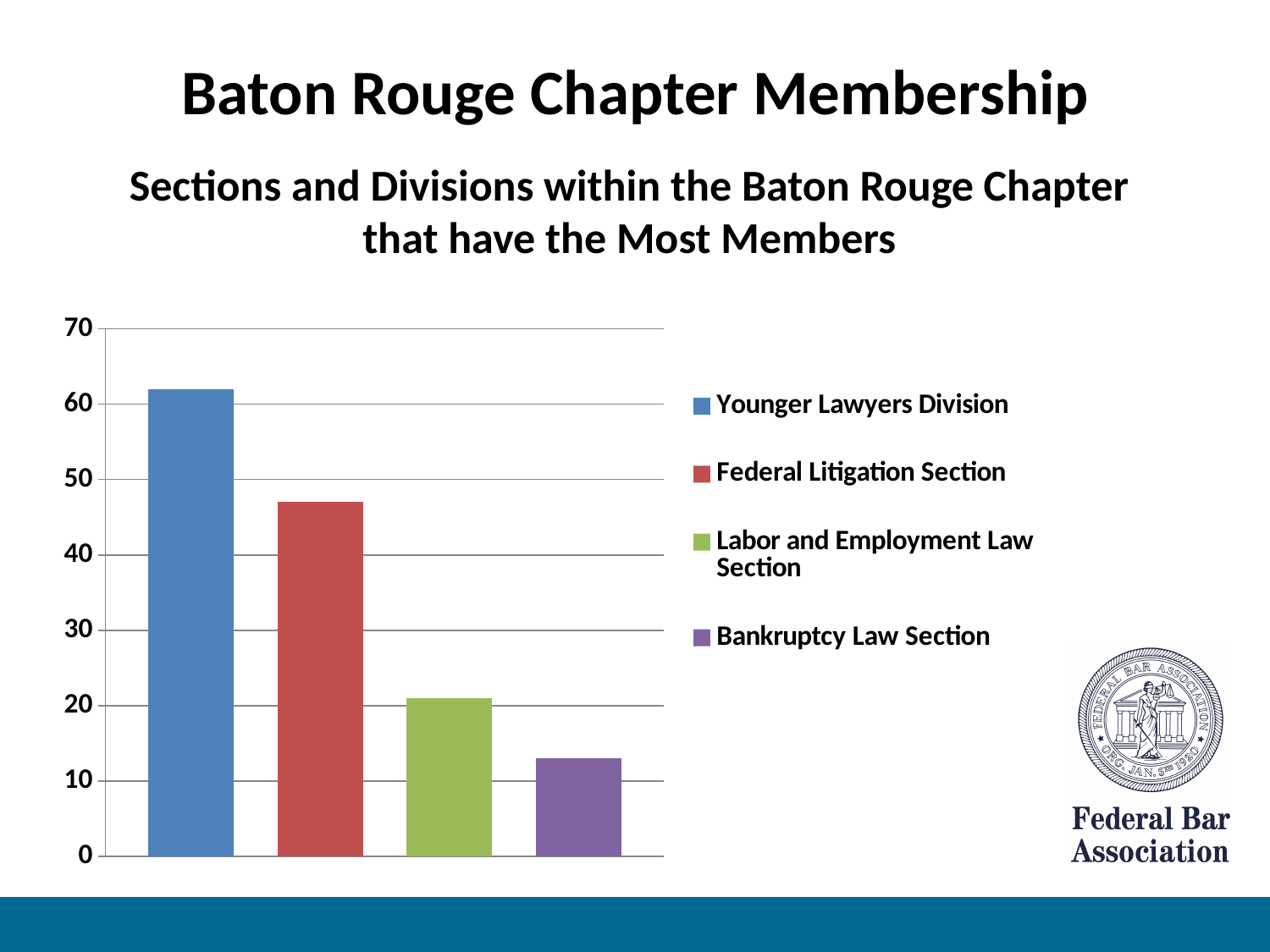
Is the value for the Bankruptcy Law Section greater or less than 20? less What colour is the bar for the Federal Litigation Section? red Is the value for the Younger Lawyers Division greater or less than 60? greater What kind of chart is shown on the slide? bar chart Which has more members, the Federal Litigation Section or the Labor and Employment Law Section? Federal Litigation Section How many entries does the legend list? 4 How many bars are plotted in the chart? 4 Is the value for the Federal Litigation Section greater or less than 50? less Which section or division has the highest number of members? Younger Lawyers Division Which has more members, the Labor and Employment Law Section or the Bankruptcy Law Section? Labor and Employment Law Section Which section or division has the lowest number of members? Bankruptcy Law Section